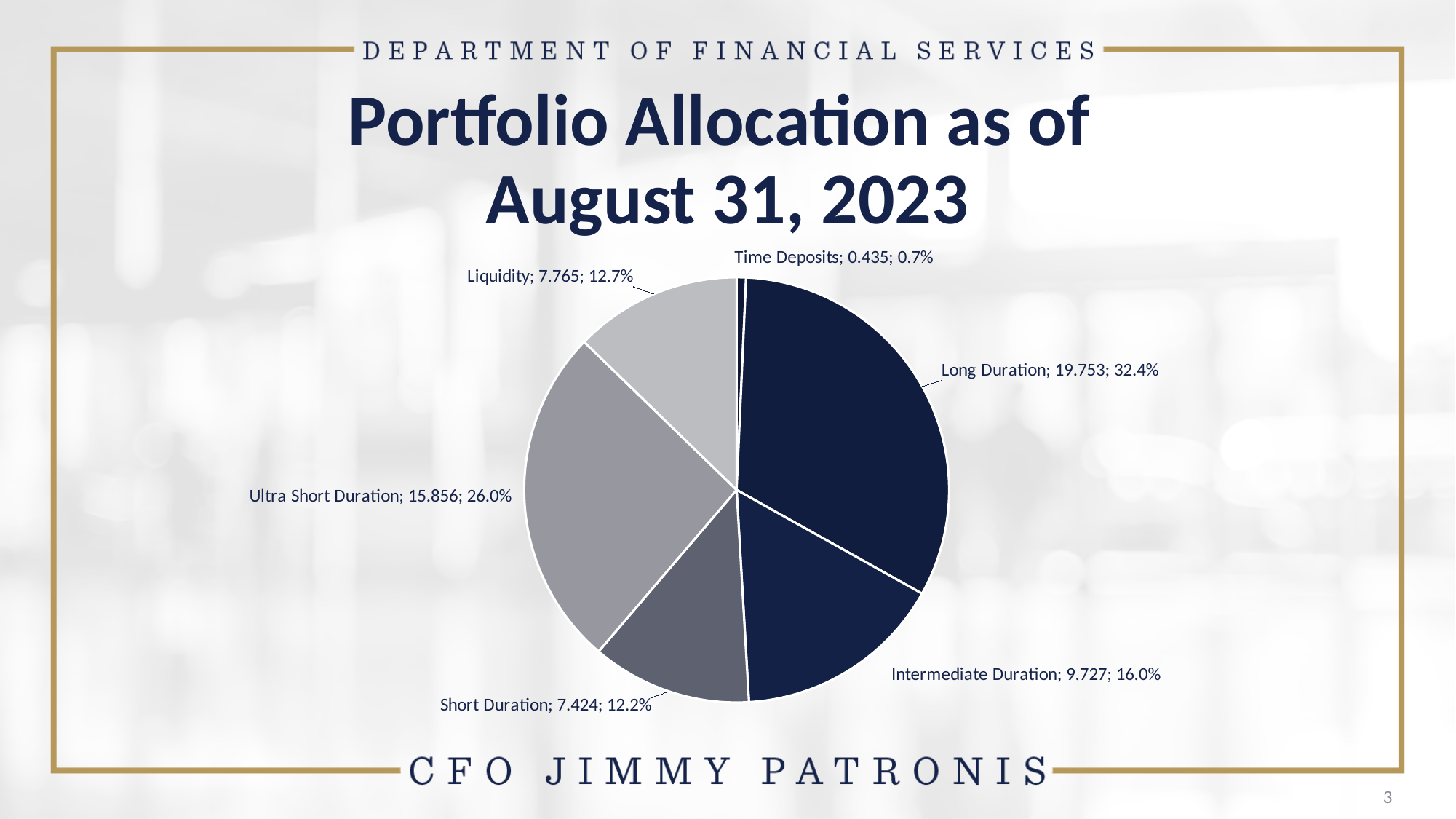
What is the percentage shown for Intermediate Duration? 16.0% What share of the pie does Ultra Short Duration represent? 26.0% Which is larger, the value for Short Duration or the value for Liquidity? Liquidity Which category has the smallest slice of the pie? Time Deposits What percentage is shown for Liquidity? 12.7% What is the title of the chart on the slide? Portfolio Allocation as of August 31, 2023 How many categories are shown in the pie chart? 6 What kind of chart is shown on the slide? Pie chart Which category has the largest slice of the pie? Long Duration What is the value for Long Duration? 19.753 What is the difference between the values for Long Duration and Intermediate Duration? 10.026 What is the value for Time Deposits? 0.435